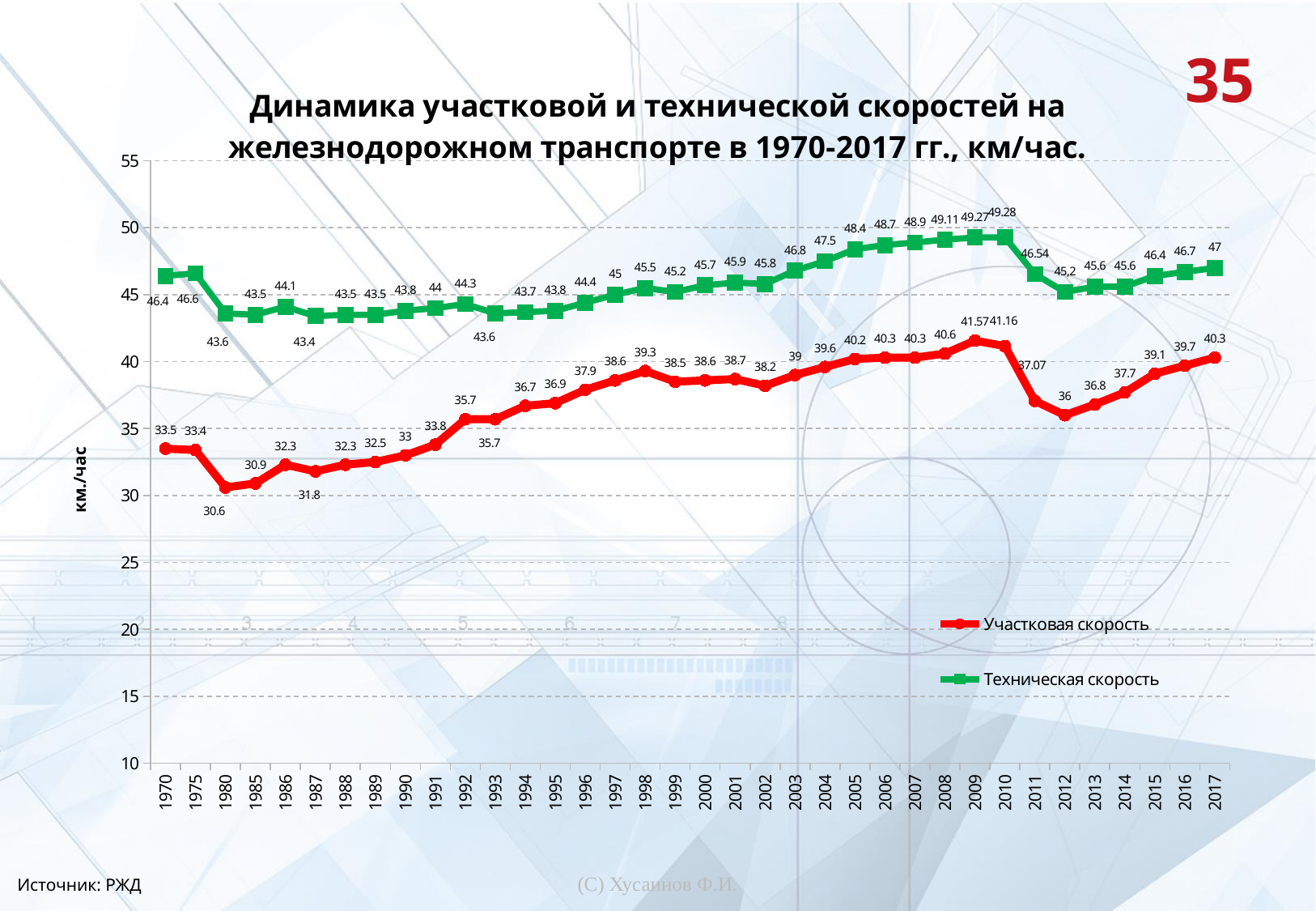
What kind of chart is shown on the slide? line chart In which year does Участковая скорость reach its highest value? 2009 What is the difference between Техническая скорость and Участковая скорость in 2017? 6.7 How many series does the legend list? 2 Which colour is used for the Техническая скорость series? green What is the value of Участковая скорость in 2017? 40.3 How many years are shown on the x axis? 36 Is the value of Участковая скорость in 1980 greater or less than 35? less By how much did Участковая скорость fall from 2010 to 2011? 4.09 Which is larger: Техническая скорость in 1970 or in 2017? 2017 What is the value of Техническая скорость in 2010? 49.28 What is the value of Участковая скорость in 1980? 30.6